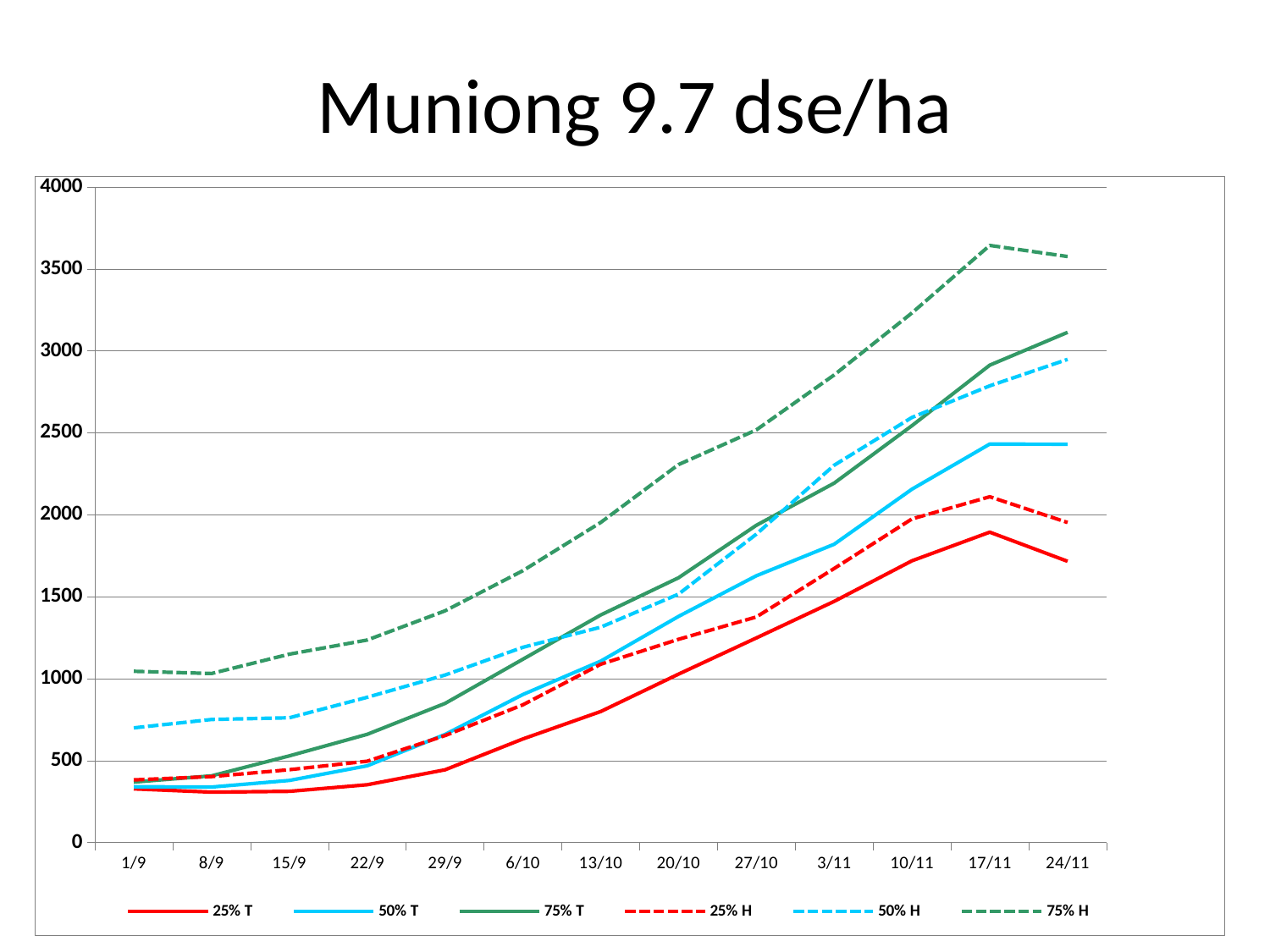
Is the value for 75% H at 17/11 greater or less than 3500? greater What is the title of the chart? Muniong 9.7 dse/ha Which series has the lowest value at 24/11? 25% T What kind of chart is shown on the slide? line chart How many dates are shown along the x axis? 13 Is the value for 25% T at 1/9 greater or less than 500? less How many series does the legend list? 6 Which series has the highest value at 24/11? 75% H Do the values of the 50% T series generally rise or fall from 1/9 to 17/11? rise At which date does the 75% H series reach its highest value? 17/11 At 24/11, which is larger: 75% T or 50% T? 75% T Is the value for 75% T at 24/11 greater or less than 3000? greater